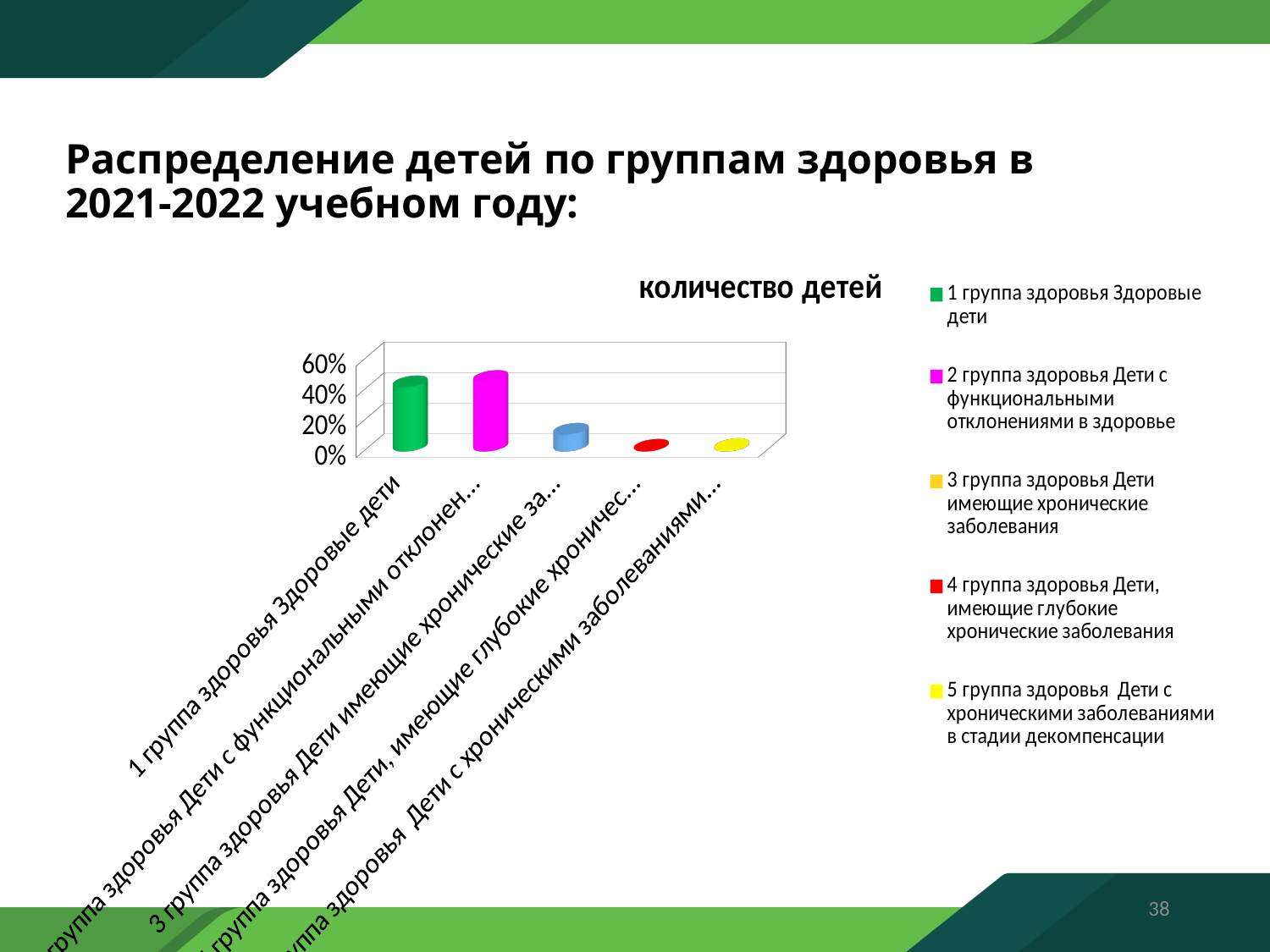
Is the value for '1 группа здоровья Здоровые дети' greater or less than 60%? less What is the title of the chart? количество детей What kind of chart is shown on the slide? bar chart Is the value for '4 группа здоровья Дети, имеющие глубокие хронические заболевания' greater or less than 20%? less Is the value for '2 группа здоровья Дети с функциональными отклонениями в здоровье' greater or less than 40%? greater What colour does the legend use for '1 группа здоровья Здоровые дети'? green Which is larger: the value for '2 группа здоровья Дети с функциональными отклонениями в здоровье' or for '5 группа здоровья Дети с хроническими заболеваниями в стадии декомпенсации'? 2 группа здоровья Дети с функциональными отклонениями в здоровье How many health-group categories are plotted in the chart? 5 How many entries does the chart legend list? 5 Which is larger: the value for '1 группа здоровья Здоровые дети' or for '3 группа здоровья Дети имеющие хронические заболевания'? 1 группа здоровья Здоровые дети